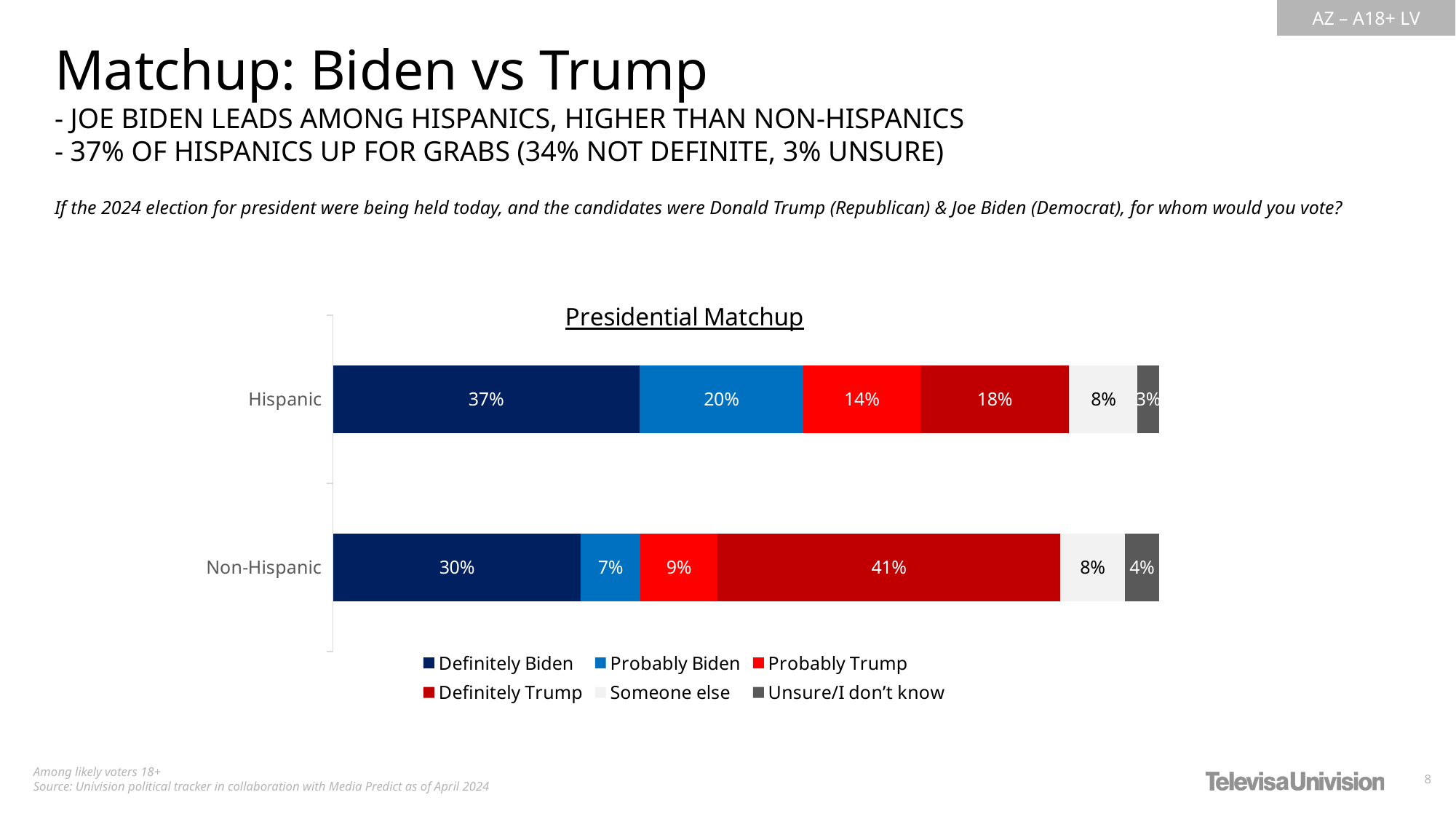
Which group has a higher Probably Biden share, Hispanic or Non-Hispanic? Hispanic Which response category has the smallest share among Hispanic respondents? Unsure/I don't know Which response category has the largest share among Non-Hispanic respondents? Definitely Trump What percentage of Non-Hispanic respondents said Definitely Trump? 41% What is the difference between the Definitely Trump share for Non-Hispanic and Hispanic respondents? 23 percentage points What percentage of Hispanic respondents said Definitely Biden? 37% What kind of chart is shown on the slide? Stacked horizontal bar chart What is the title of the chart? Presidential Matchup What percentage of Hispanic respondents said Probably Biden? 20% How many series does the legend list? 6 What percentage of Non-Hispanic respondents said Unsure/I don't know? 4% How many groups (categories) are shown on the chart? 2